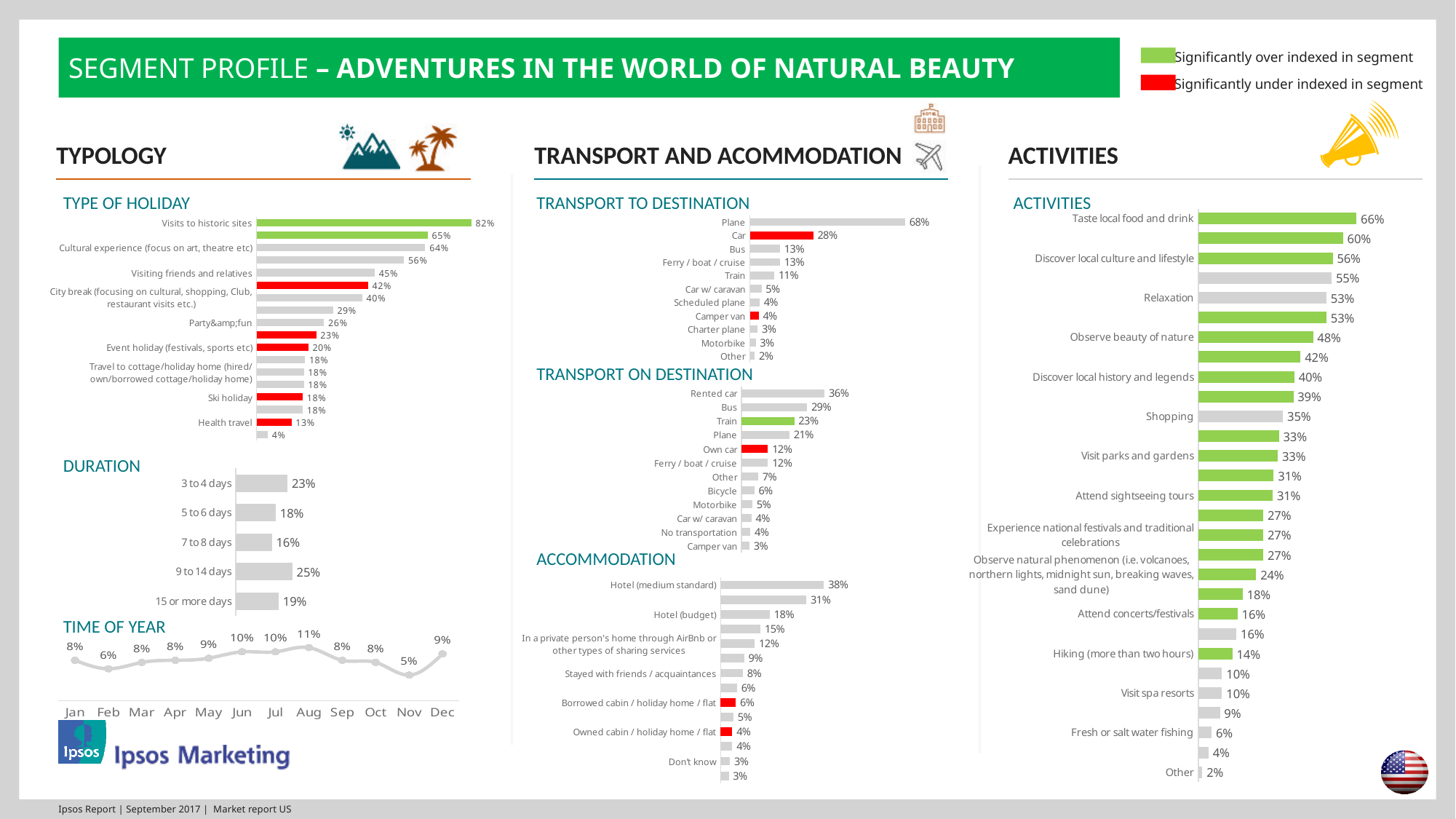
In the Duration chart, what is the value for 9 to 14 days? 25% In the Transport to Destination chart, what is the difference between Plane and Car? 40% What kind of chart is the Time of Year chart? Line chart In the Transport to Destination chart, what is the value for Plane? 68% In the Time of Year chart, what is the value for Nov? 5% In the Duration chart, which duration category has the lowest value? 7 to 8 days In the Activities chart, what is the value for Taste local food and drink? 66% In the Transport on Destination chart, which is larger, Rented car or Bus? Rented car In the Time of Year chart, which month has the highest value? Aug In the Accommodation chart, what is the value for Hotel (medium standard)? 38% How many duration categories are shown in the Duration chart? 5 How many categories are listed in the Transport on Destination chart? 12